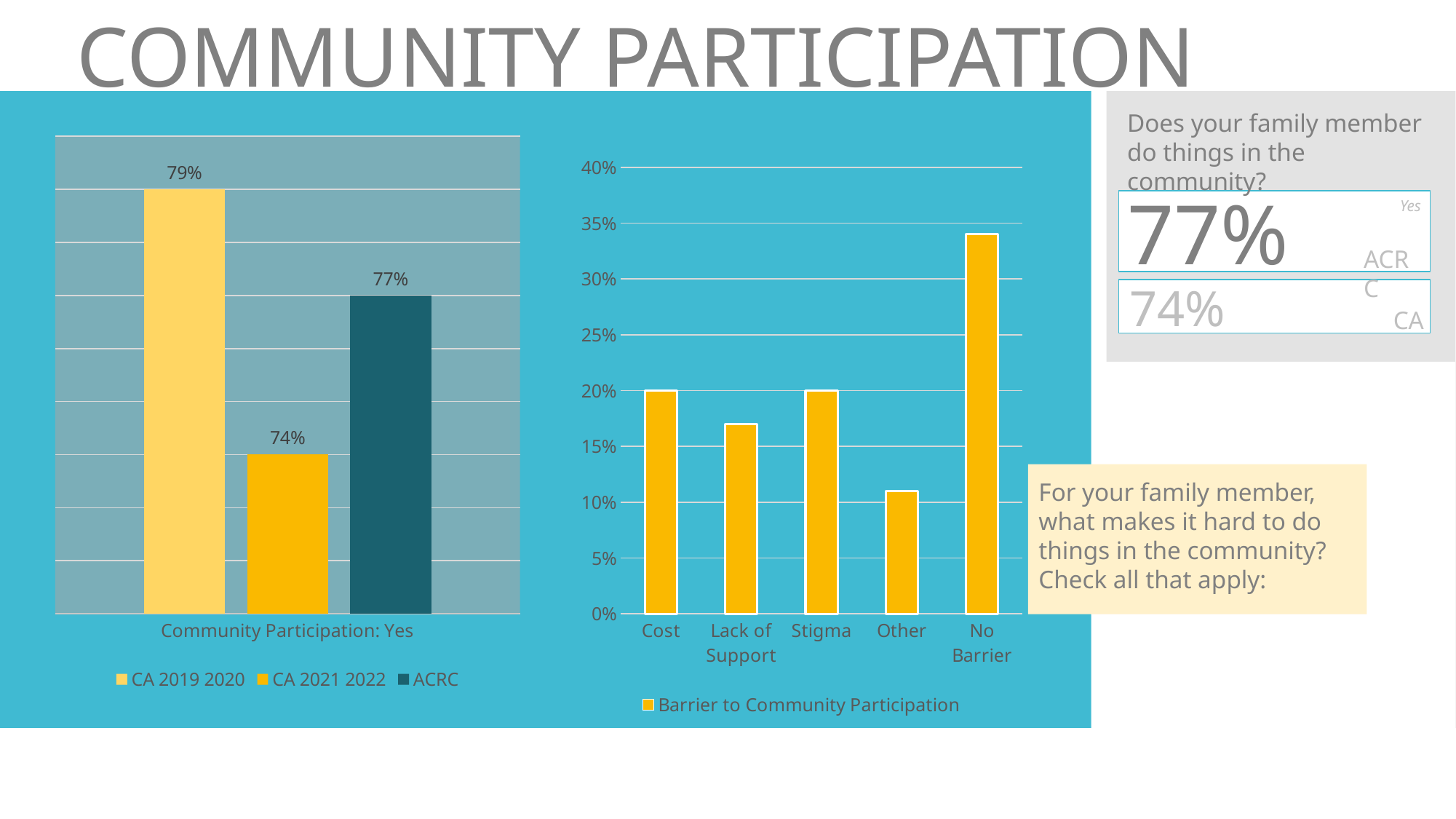
In the left chart, what is the value for CA 2019 2020? 79% What kind of chart is the right chart? bar chart In the left chart, what is the value for CA 2021 2022? 74% In the left chart, which series has the lowest value? CA 2021 2022 In the right chart, which barrier has the highest value? No Barrier In the right chart, is the value for No Barrier greater or less than 30%? greater In the left chart, which series has the highest value? CA 2019 2020 In the right chart, which barrier has the lowest value? Other In the right chart, how many barrier categories are shown on the x axis? 5 In the left chart, what is the value for ACRC? 77% In the left chart, how many series does the legend list? 3 In the left chart, what is the difference between the CA 2019 2020 value and the CA 2021 2022 value? 5%